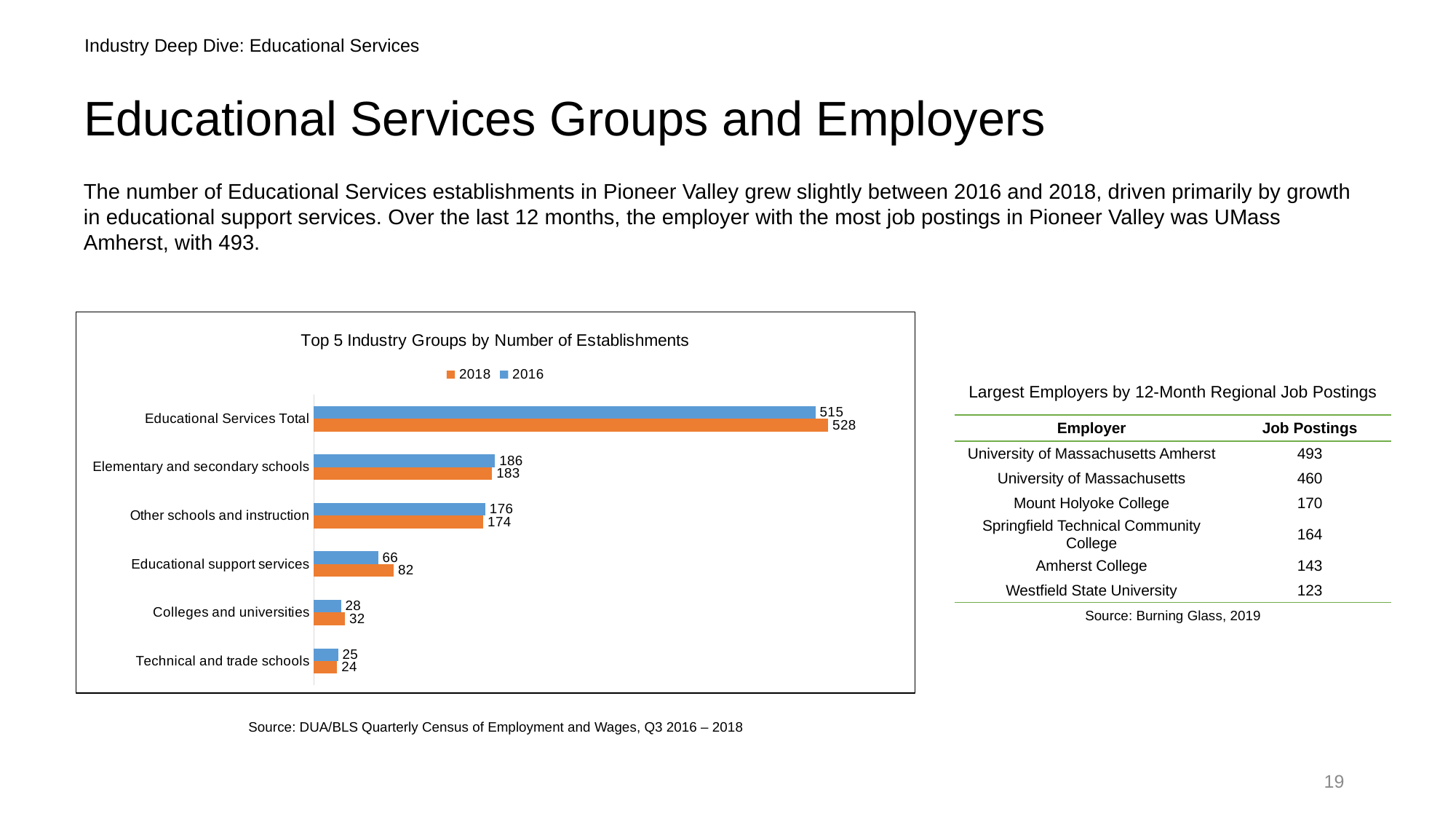
Excluding the Educational Services Total, which category has the highest 2016 value in the Top 5 Industry Groups chart? Elementary and secondary schools Excluding the Educational Services Total, which category has the lowest 2018 value in the Top 5 Industry Groups chart? Technical and trade schools What is the 2018 value for Educational Services Total in the Top 5 Industry Groups chart? 528 How many categories are shown on the Top 5 Industry Groups by Number of Establishments chart? 6 In the Top 5 Industry Groups chart, what is the difference between the 2018 and 2016 values for Educational support services? 16 What is the 2018 value for Educational support services in the Top 5 Industry Groups chart? 82 What is the title of the bar chart on the slide? Top 5 Industry Groups by Number of Establishments How many series does the legend of the Top 5 Industry Groups chart list? 2 In the Top 5 Industry Groups chart, is the 2016 or the 2018 value larger for Other schools and instruction? 2016 In the Top 5 Industry Groups chart, what is the difference between the 2018 and 2016 values for Educational Services Total? 13 What is the 2016 value for Elementary and secondary schools in the Top 5 Industry Groups chart? 186 What type of chart is used to show the Top 5 Industry Groups by Number of Establishments? bar chart